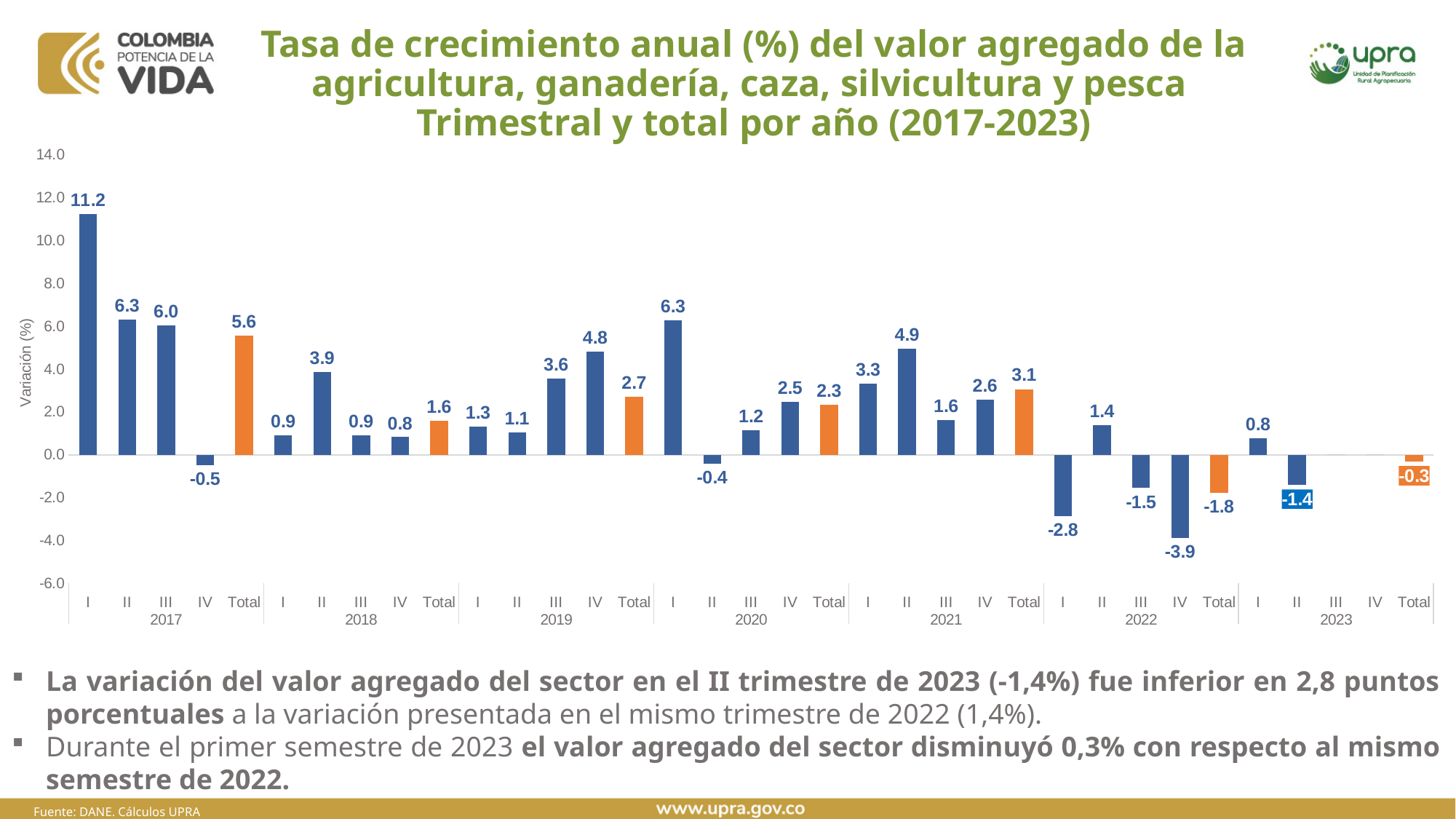
What value is shown for quarter IV of 2022? -3.9 How many annual Total bars are shown on the chart? 7 Which quarter has the highest growth rate on the chart? I 2017 What kind of chart is shown on the slide? Bar chart Which is larger, the Total for 2019 or the Total for 2021? Total 2021 Which quarter has the lowest growth rate on the chart? IV 2022 Do the values for the four quarters of 2017 rise or fall from quarter I to quarter IV? Fall What colour are the annual Total bars on the chart? Orange Is the value for quarter I of 2017 greater or less than 10.0? greater What is the difference between the value for quarter II of 2022 and quarter II of 2023? 2.8 What value is shown for quarter II of 2023? -1.4 What is the annual growth rate shown for the Total of 2017? 5.6